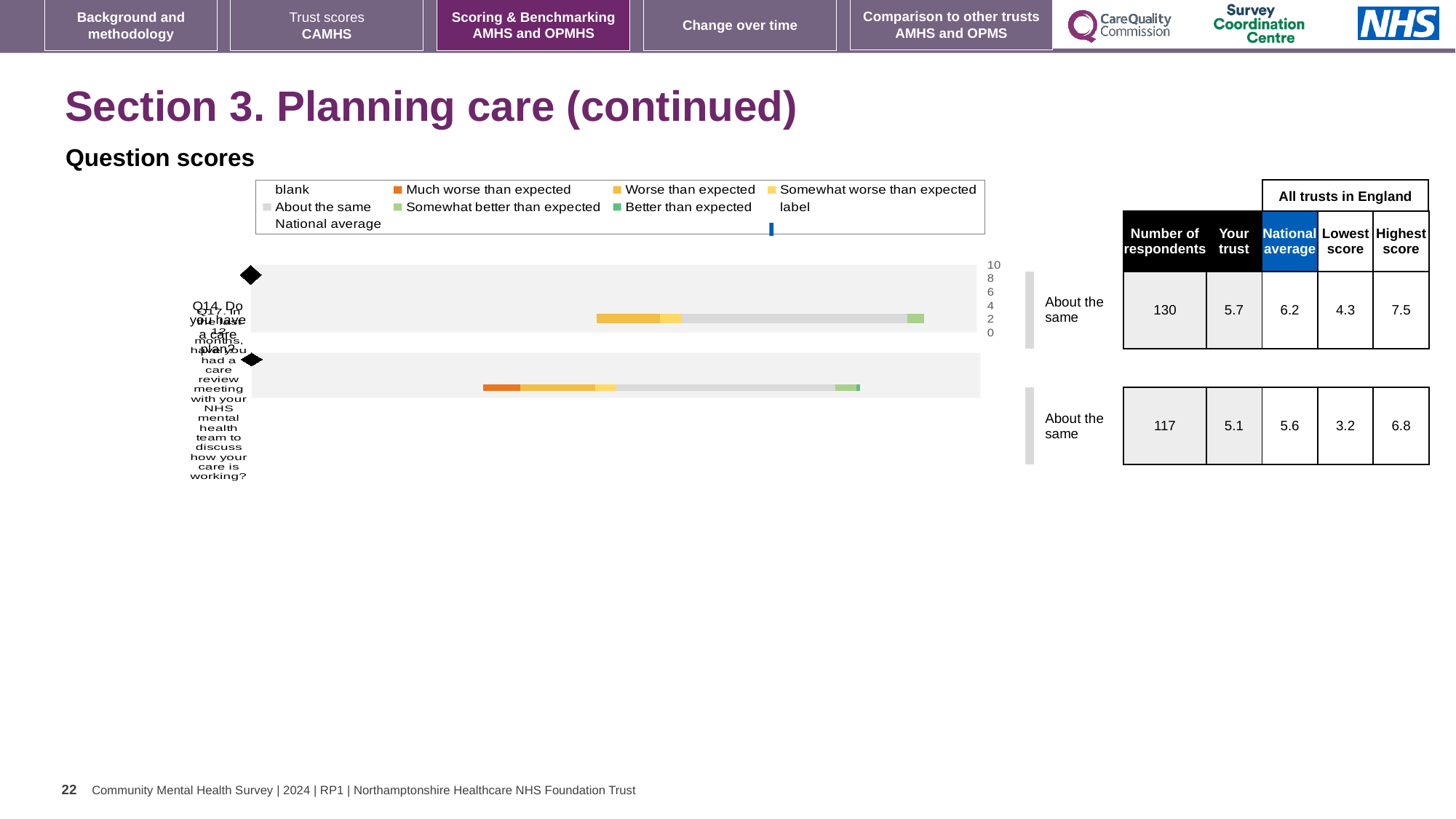
How many questions (bars) are plotted in the chart? 2 What kind of chart is shown under 'Question scores'? bar chart Which colour does the legend use for 'Much worse than expected'? orange In the table beside the chart, which question has the higher 'Your trust' score, Q14 or Q17? Q14 Which colour does the legend use for 'Better than expected'? green In the table beside the chart, what is the difference between the national average and 'Your trust' score for Q14? 0.5 In the table beside the chart, how many respondents answered Q14 'Do you have a care plan?'? 130 In the table beside the chart, what is the highest score among all trusts in England for Q17? 6.8 What benchmark category is shown next to the bar for Q14 'Do you have a care plan?'? About the same What benchmark category is shown next to the bar for Q17 about having a care review meeting? About the same In the table beside the chart, what is the national average for Q17 about having a care review meeting? 5.6 In the table beside the chart, what is the 'Your trust' score for Q14 'Do you have a care plan?'? 5.7